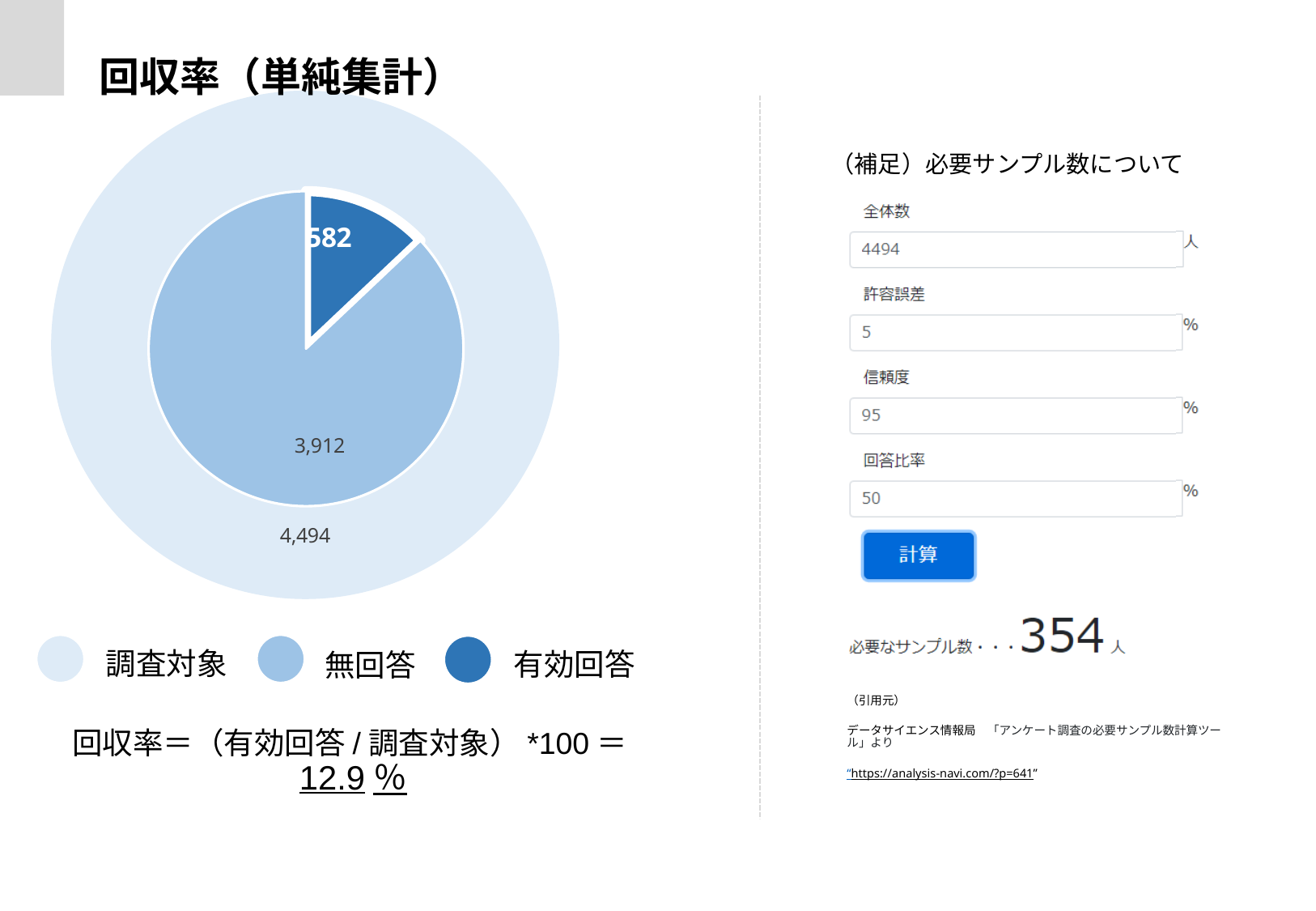
What kind of chart is shown on the left of the slide? pie chart Which slice of the pie chart is the largest? 無回答 How many slices does the pie chart have? 2 Which slice of the pie chart is the smallest? 有効回答 What share of 調査対象 does 有効回答 represent, as stated on the slide? 12.9 % What is the value shown for 調査対象 in the chart? 4,494 What is the value for 無回答 in the pie chart? 3,912 Which is larger, 有効回答 or 無回答? 無回答 What is the value for 有効回答 in the pie chart? 582 What is the title of the slide containing the pie chart? 回収率（単純集計） How many entries does the legend below the chart list? 3 What is the difference between the 無回答 value and the 有効回答 value? 3,330